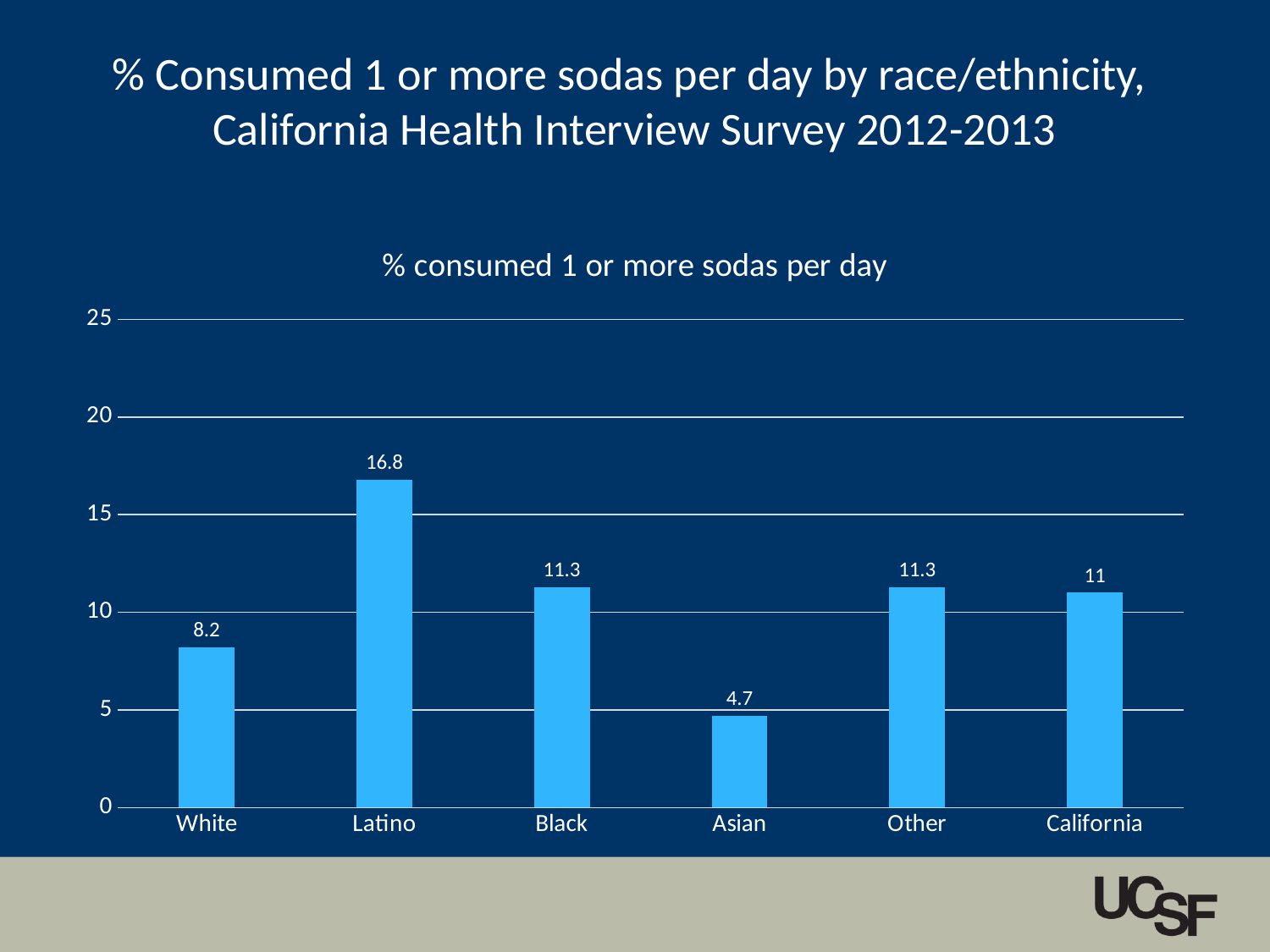
What is the value for California? 11 What is the difference between the values for Black and Asian? 6.6 What is the value for White? 8.2 Which is larger, the value for White or the value for Black? Black What kind of chart is this? bar chart What is the value for Latino? 16.8 What is the title of the chart? % consumed 1 or more sodas per day What is the value for Asian? 4.7 Which category has the lowest value? Asian How many categories are shown on the x axis? 6 What is the difference between the values for Latino and White? 8.6 Which category has the highest value? Latino